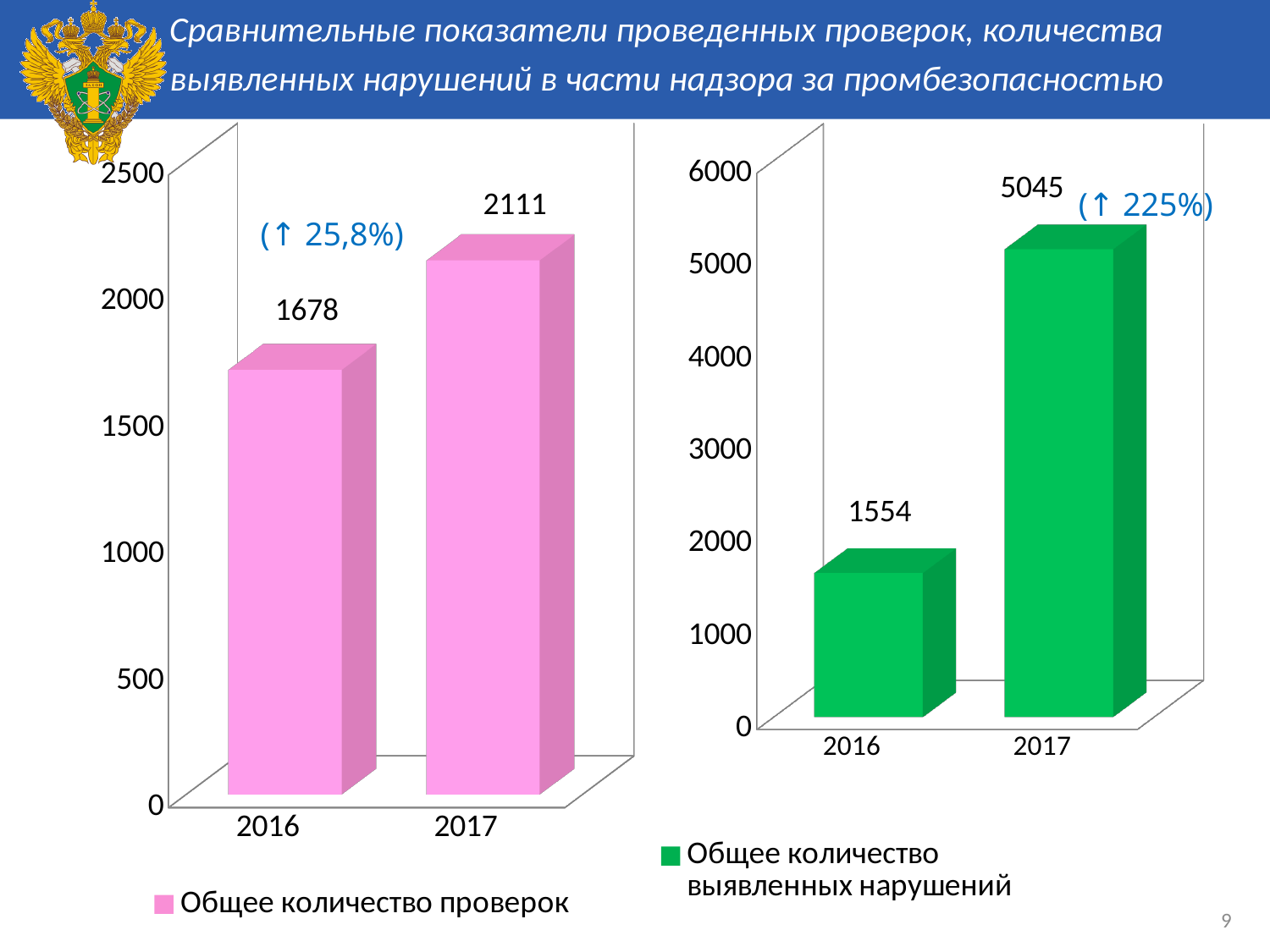
In the right chart (Общее количество выявленных нарушений), which year has the lower value? 2016 In the right chart (Общее количество выявленных нарушений), is the value for 2017 greater or less than 4000? greater In the right chart (Общее количество выявленных нарушений), what is the value for 2017? 5045 In the left chart (Общее количество проверок), what is the value for 2016? 1678 In the right chart (Общее количество выявленных нарушений), what is the difference between the 2017 and 2016 values? 3491 What percentage increase is annotated on the right chart (Общее количество выявленных нарушений)? 225% In the right chart (Общее количество выявленных нарушений), what is the value for 2016? 1554 In the left chart (Общее количество проверок), what is the difference between the 2017 and 2016 values? 433 What type of chart is the right chart (Общее количество выявленных нарушений)? bar chart In the left chart (Общее количество проверок), what is the value for 2017? 2111 In the left chart (Общее количество проверок), which year has the higher value? 2017 How many categories are shown on the x axis of the left chart (Общее количество проверок)? 2